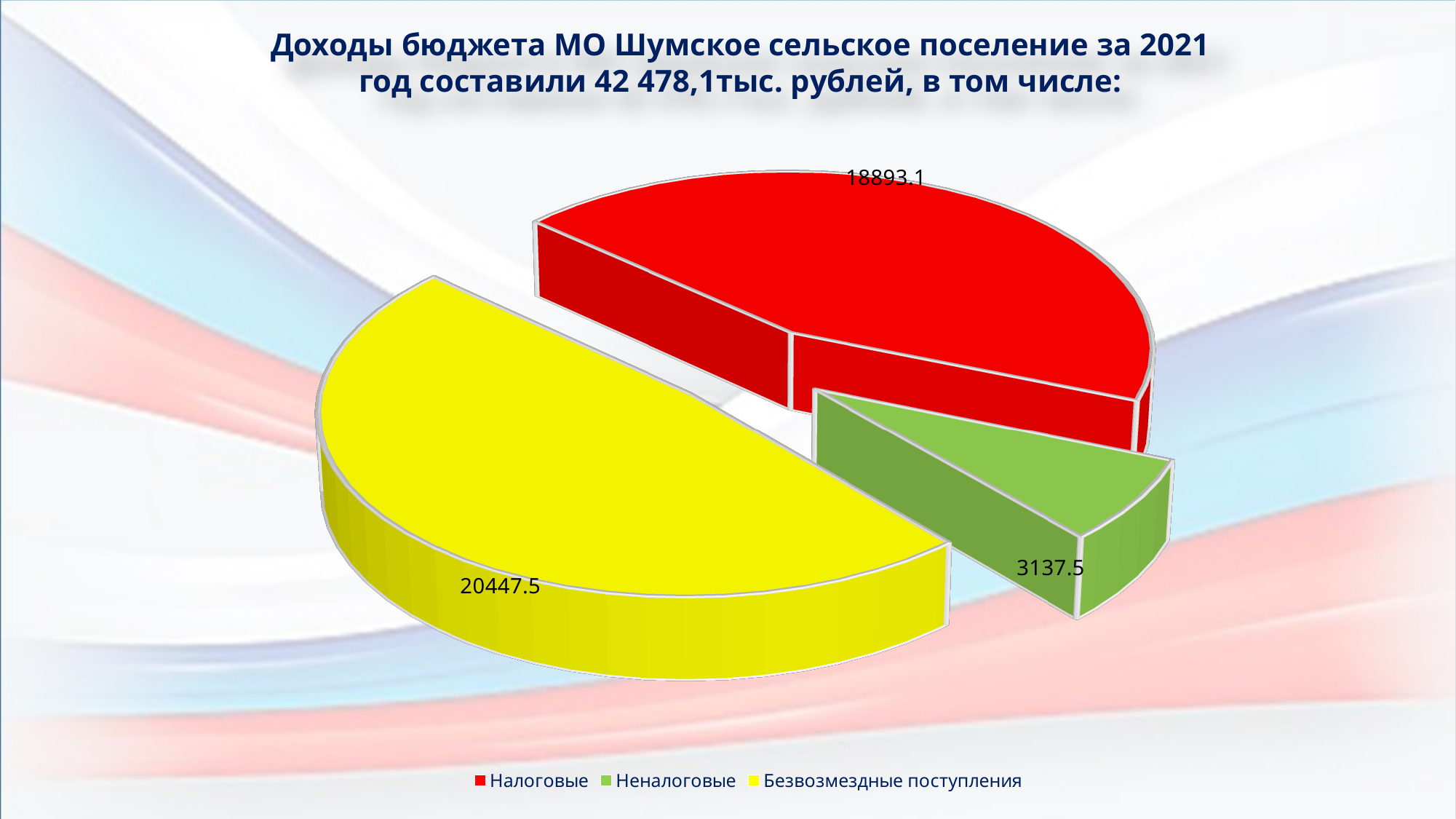
What is the difference between the Безвозмездные поступления and Налоговые values? 1554.4 Which category has the smallest value in the pie chart? Неналоговые What type of chart is shown on the slide? Pie chart What is the value of the Неналоговые slice? 3137.5 What is the difference between the Налоговые and Неналоговые values? 15755.6 How many entries does the legend list? 3 What colour is the Безвозмездные поступления slice? Yellow Which category has the largest value in the pie chart? Безвозмездные поступления How many slices does the pie chart have? 3 Which is larger, Налоговые or Неналоговые? Налоговые What is the value of the Безвозмездные поступления slice? 20447.5 What is the value of the Налоговые slice? 18893.1